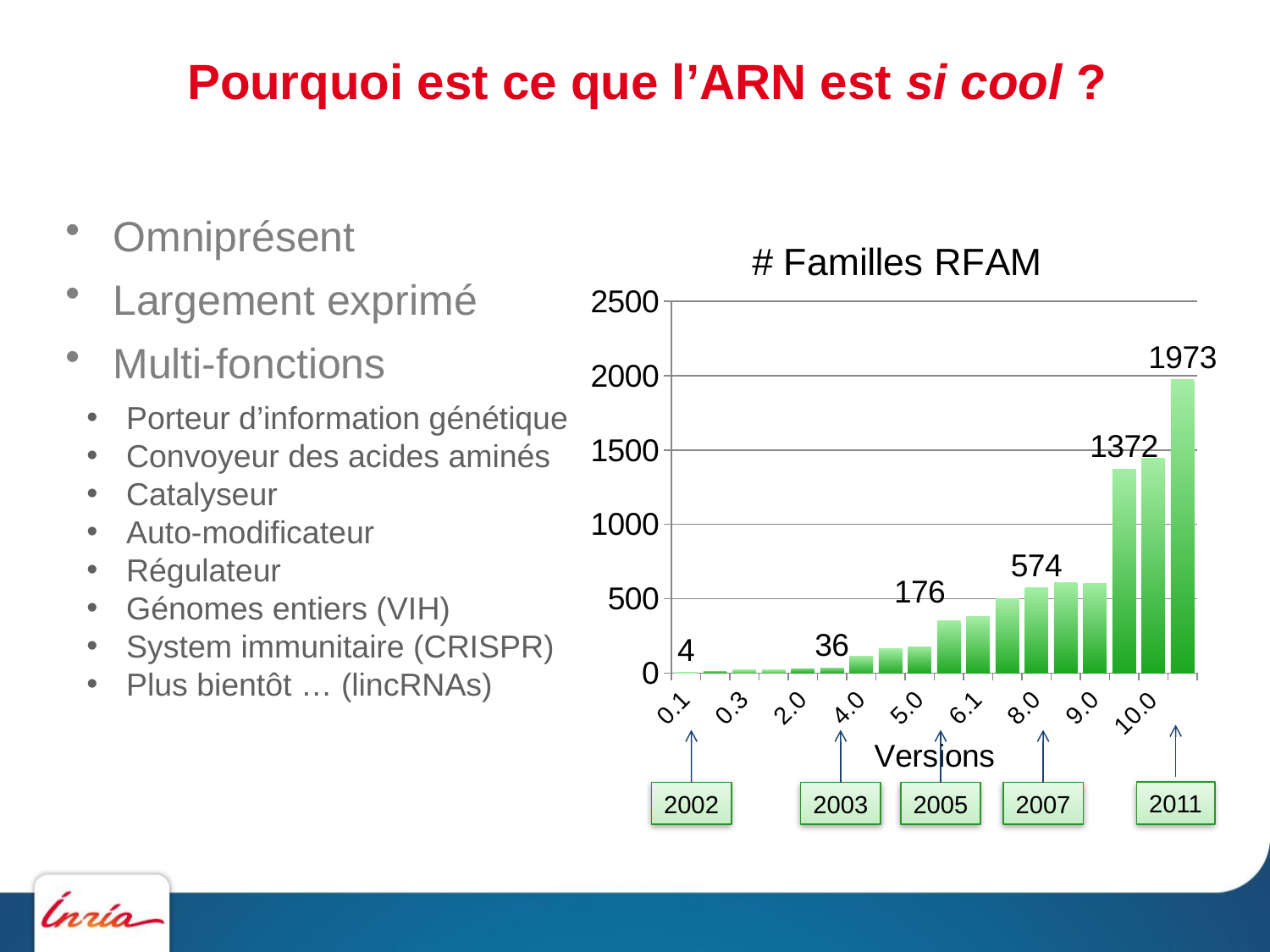
What kind of chart is shown on the slide? bar chart What is the title of the chart? # Familles RFAM Do the values generally rise or fall from left to right along the Versions axis? rise What is the difference between the labeled values 36 and 4? 32 Which is larger, the bar labeled 1372 or the bar labeled 574? 1372 What is the lowest value labeled on the chart? 4 What is the difference between the labeled values 574 and 176? 398 Which year is annotated below the rightmost bar of the chart? 2011 What is the difference between the two highest labeled values, 1973 and 1372? 601 What is the highest value labeled on the chart? 1973 Is the value of the tallest bar greater or less than 1500? greater Is the value of the first bar on the left greater or less than 500? less